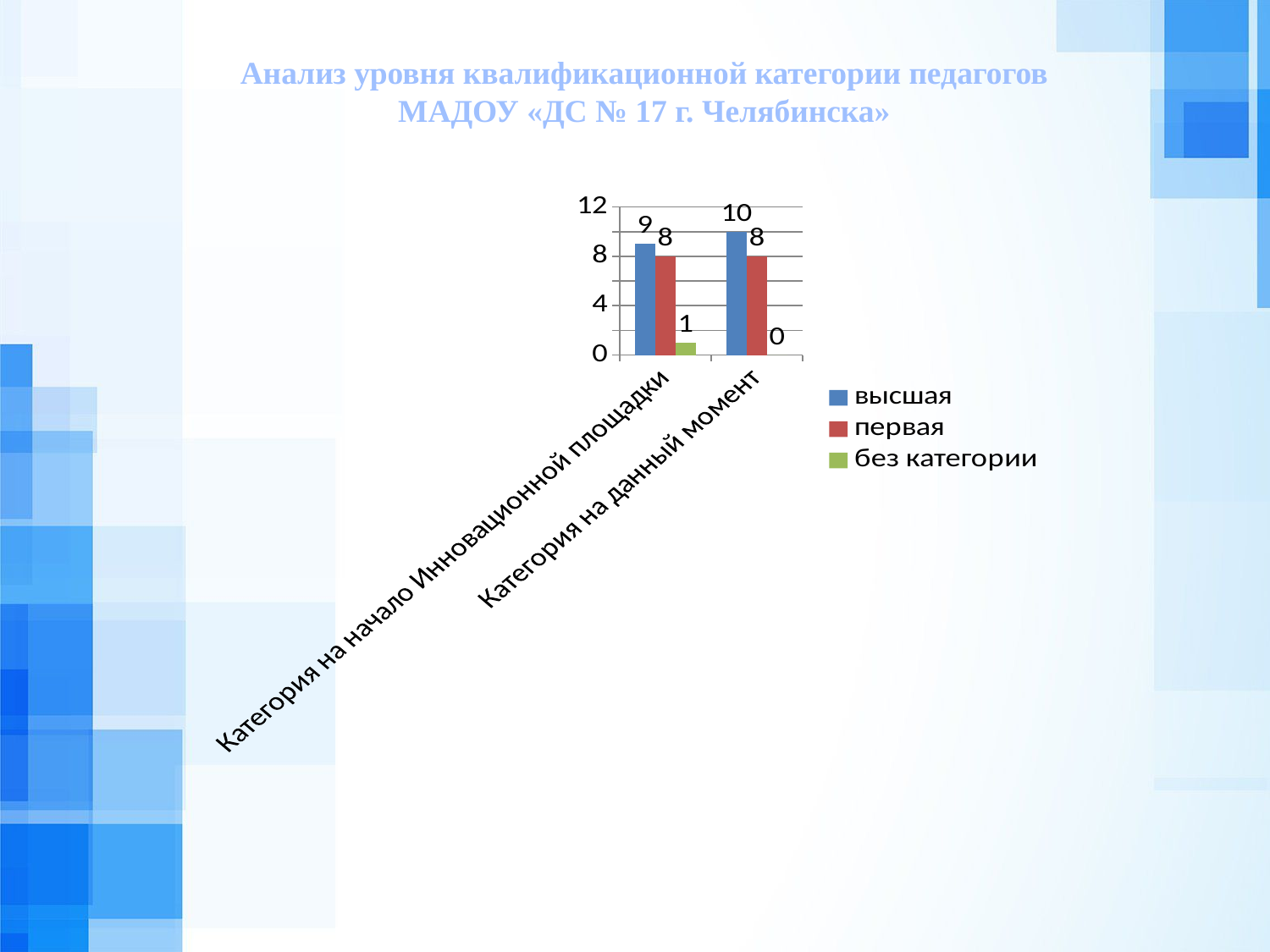
What is the value for "без категории" in the category "Категория на данный момент"? 0 Which legend entry is shown in green? без категории What type of chart is shown on the slide? bar chart How many series does the legend list? 3 Which series has the highest value in the category "Категория на данный момент"? высшая What is the value for "без категории" in the category "Категория на начало Инновационной площадки"? 1 What is the difference between the "высшая" values for "Категория на данный момент" and "Категория на начало Инновационной площадки"? 1 What is the value for "высшая" in the category "Категория на начало Инновационной площадки"? 9 What is the value for "высшая" in the category "Категория на данный момент"? 10 Which series has the lowest value in the category "Категория на начало Инновационной площадки"? без категории How many categories are shown on the x axis? 2 What is the value for "первая" in the category "Категория на данный момент"? 8